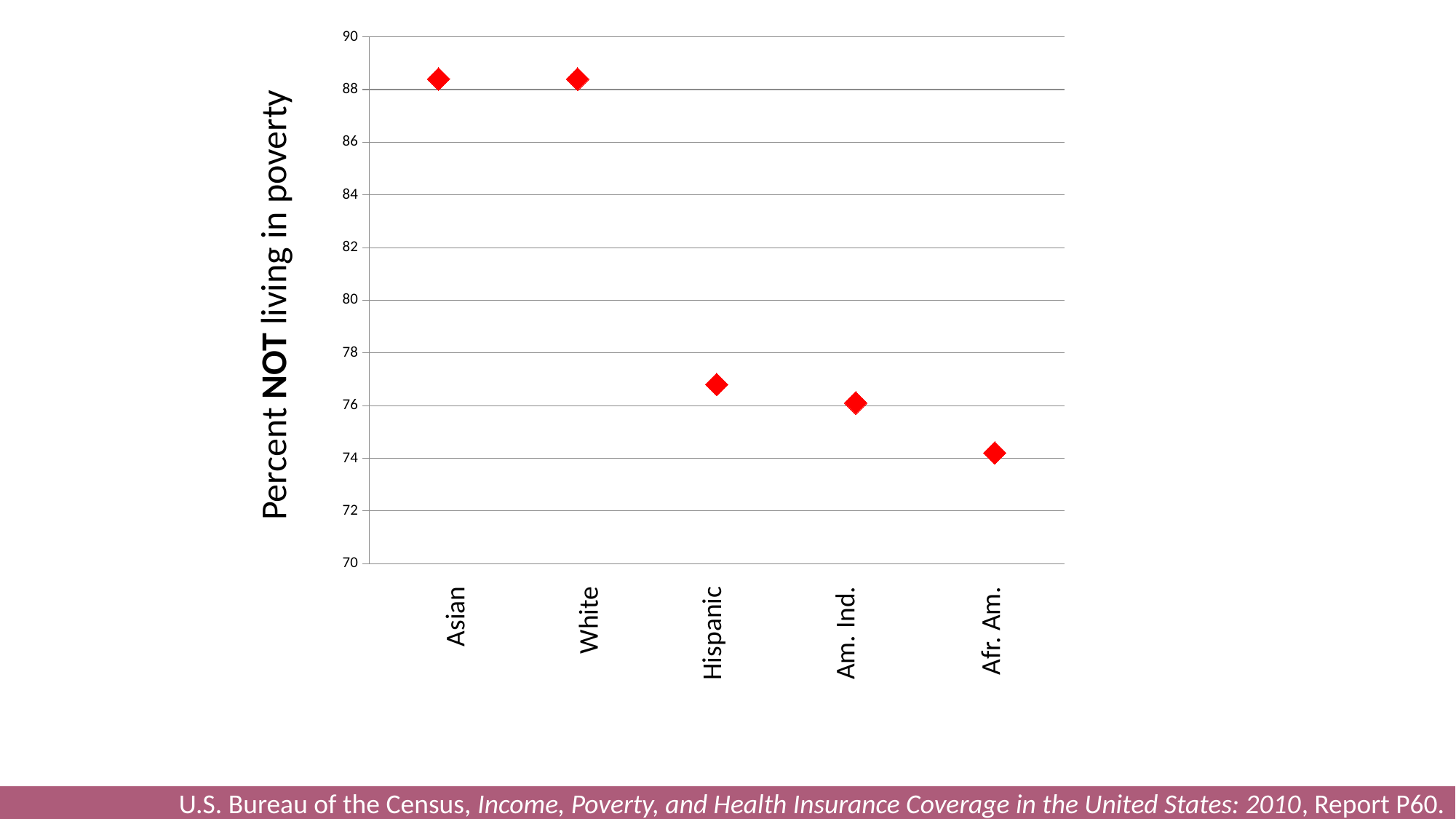
What is the label of the y axis? Percent NOT living in poverty Which is larger, the value for White or the value for Am. Ind.? White How many categories are plotted along the x axis? 5 Is the value for Asian greater or less than 88? greater Which category has the lowest percent NOT living in poverty? Afr. Am. What kind of chart is shown on the slide? scatter chart Do the values rise or fall moving from Asian to Afr. Am. along the x axis? fall Is the value for White greater or less than 86? greater Is the value for Hispanic greater or less than 78? less Which is larger, the value for Hispanic or the value for Afr. Am.? Hispanic